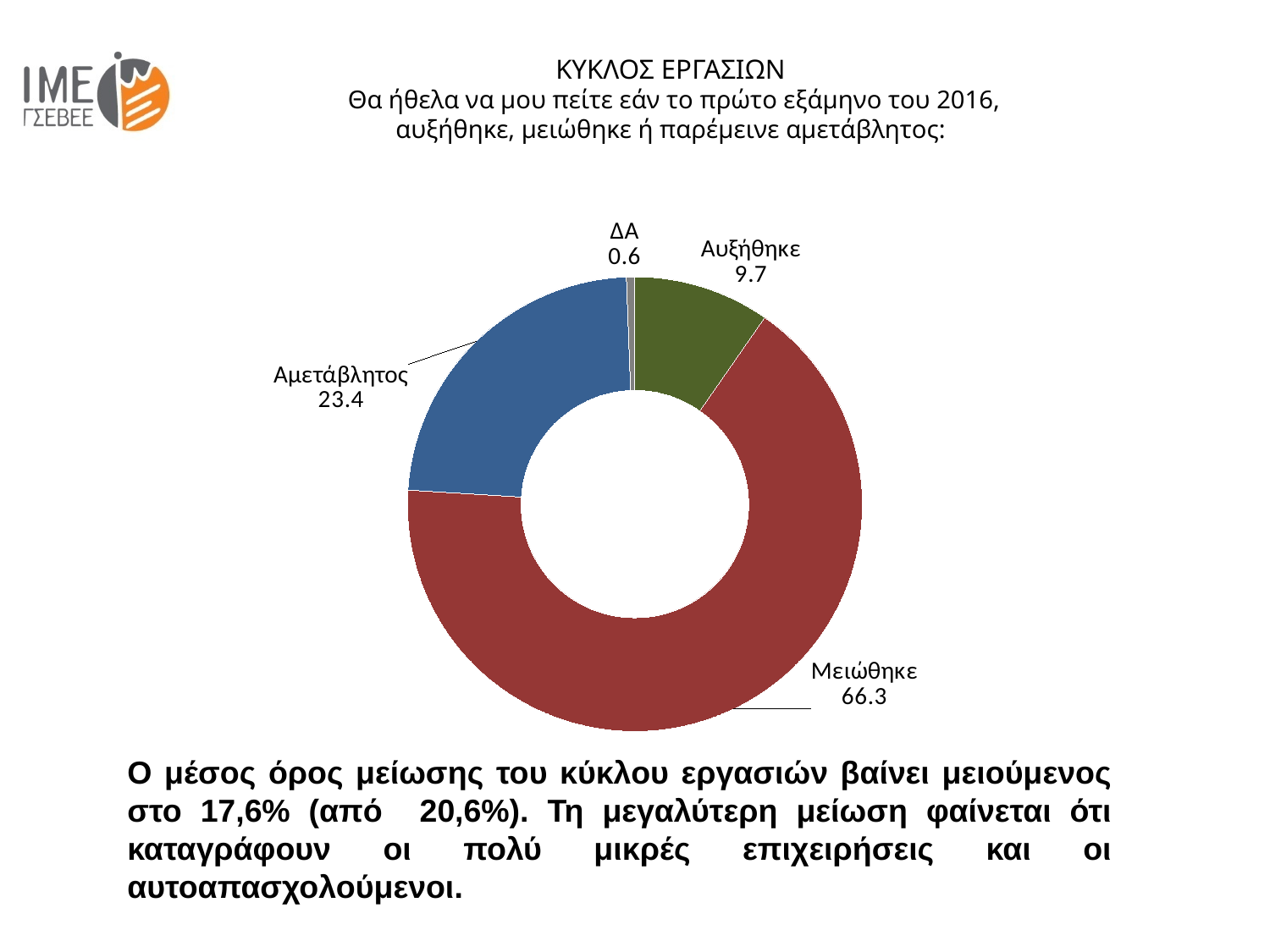
What is the title of the chart? ΚΥΚΛΟΣ ΕΡΓΑΣΙΩΝ What is the difference between the values for Αμετάβλητος and Αυξήθηκε? 13.7 What value is shown for Αμετάβλητος? 23.4 Which category has the smallest value? ΔΑ Which is larger, the value for Αυξήθηκε or the value for Αμετάβλητος? Αμετάβλητος How many categories are shown in the chart? 4 What value is shown for Αυξήθηκε? 9.7 What kind of chart is shown on the slide? Doughnut (pie) chart What value is shown for Μειώθηκε? 66.3 What is the difference between the values for Μειώθηκε and Αμετάβλητος? 42.9 Which category has the largest value? Μειώθηκε What value is shown for ΔΑ? 0.6